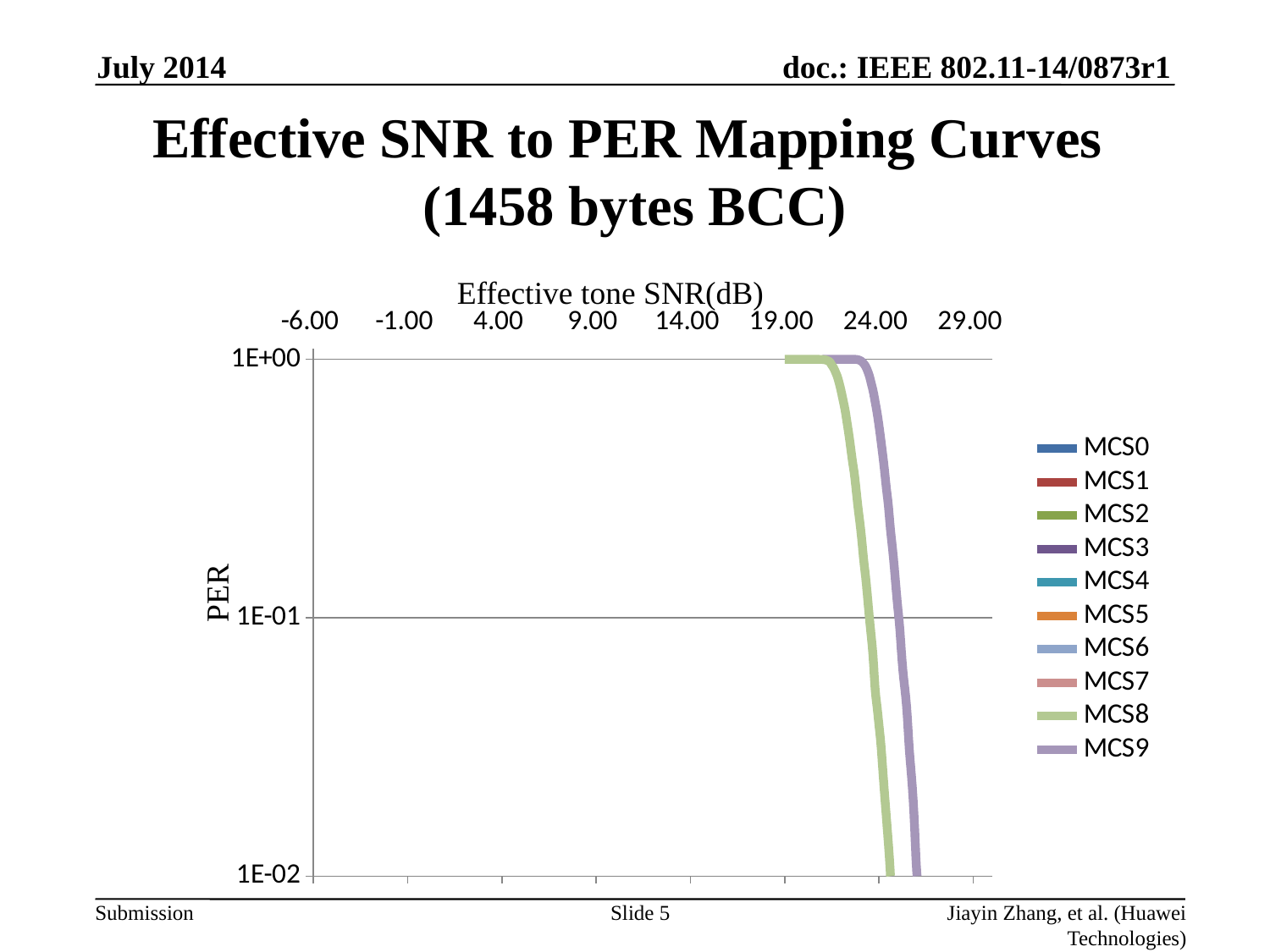
Is the effective tone SNR at which the MCS8 curve reaches a PER of 1E-01 greater or less than 19.00 dB? greater At a PER of 1E-02, which curve is at the higher effective tone SNR, MCS8 or MCS9? MCS9 Is the effective tone SNR at which the MCS9 curve reaches a PER of 1E-02 greater or less than 29.00 dB? less At a PER of 1E-01, which curve requires the higher effective tone SNR, MCS8 or MCS9? MCS9 How many series does the legend list? 10 What is the lowest PER value marked on the vertical axis? 1E-02 As the effective tone SNR increases, does the PER of the MCS8 curve rise or fall? fall What is the label of the horizontal axis? Effective tone SNR(dB) Is the effective tone SNR at which the MCS9 curve reaches a PER of 1E-01 greater or less than 24.00 dB? greater What is the label of the vertical axis? PER As the effective tone SNR increases, does the PER of the MCS9 curve rise or fall? fall What kind of chart is shown on the slide? line chart